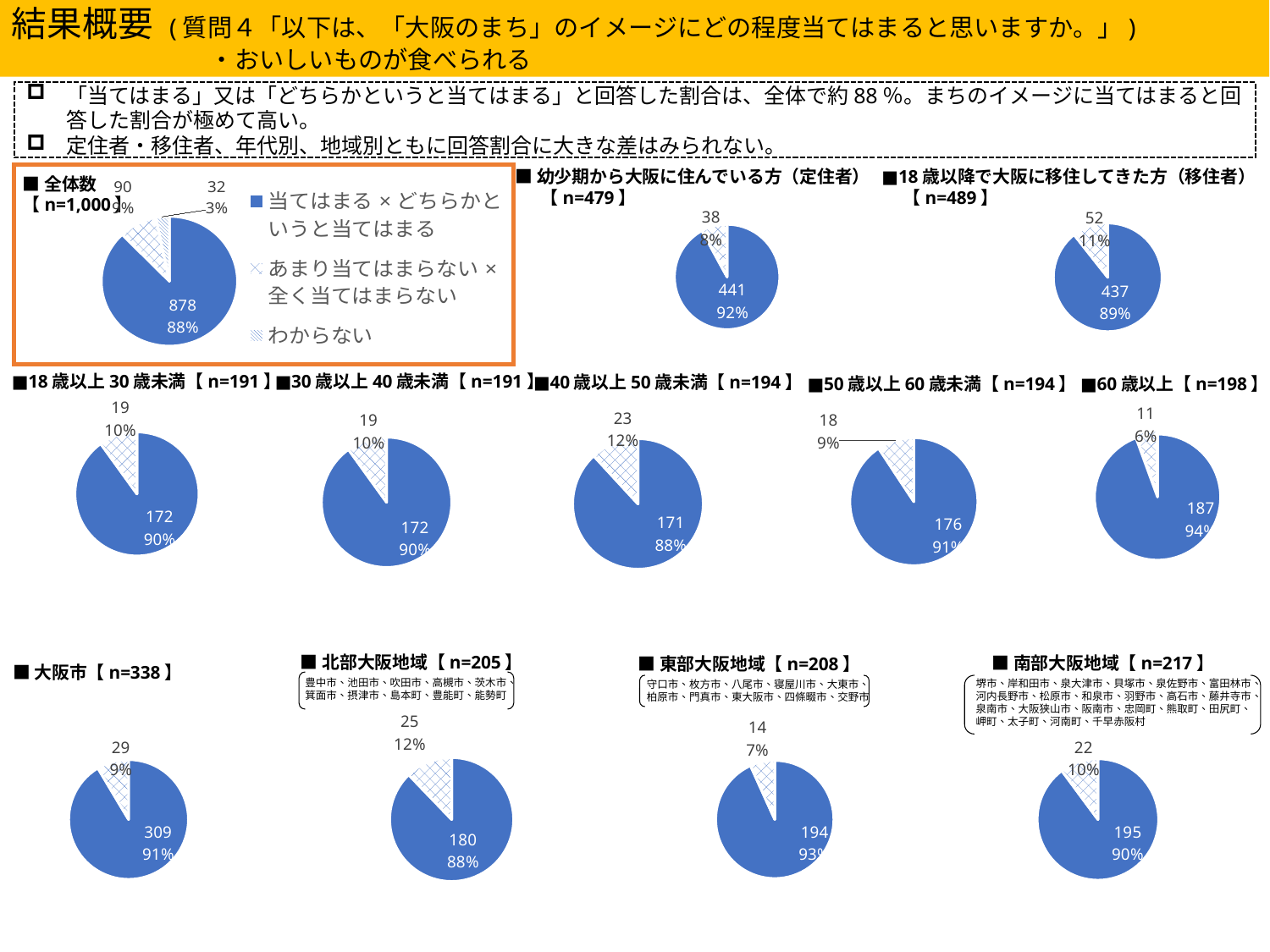
「幼少期から大阪に住んでいる方（定住者）【n=479】」の円グラフで、最も大きい区分の割合は何%ですか。 92% 「50歳以上60歳未満【n=194】」の円グラフで、小さい方の区分の回答数はいくつですか。 18 「大阪市【n=338】」の円グラフで、大きい方の区分の回答数と小さい方の区分の回答数の差はいくつですか。 280 「全体数【n=1,000】」の円グラフで、「わからない」の割合は何%ですか。 3% 「北部大阪地域【n=205】」と「南部大阪地域【n=217】」の円グラフで、大きい方の区分の割合が高いのはどちらですか。 南部大阪地域 「東部大阪地域【n=208】」の円グラフで、大きい方の区分の割合は何%ですか。 93% 「全体数【n=1,000】」の円グラフで、「当てはまる×どちらかというと当てはまる」の回答数はいくつですか。 878 「18歳以降で大阪に移住してきた方（移住者）【n=489】」の円グラフで、小さい方の区分の回答数はいくつですか。 52 このスライドで使われているグラフの種類は何ですか。 円グラフ 「全体数【n=1,000】」の円グラフの凡例には、いくつの項目がありますか。 3 「60歳以上【n=198】」の円グラフで、大きい方の区分の回答数はいくつですか。 187